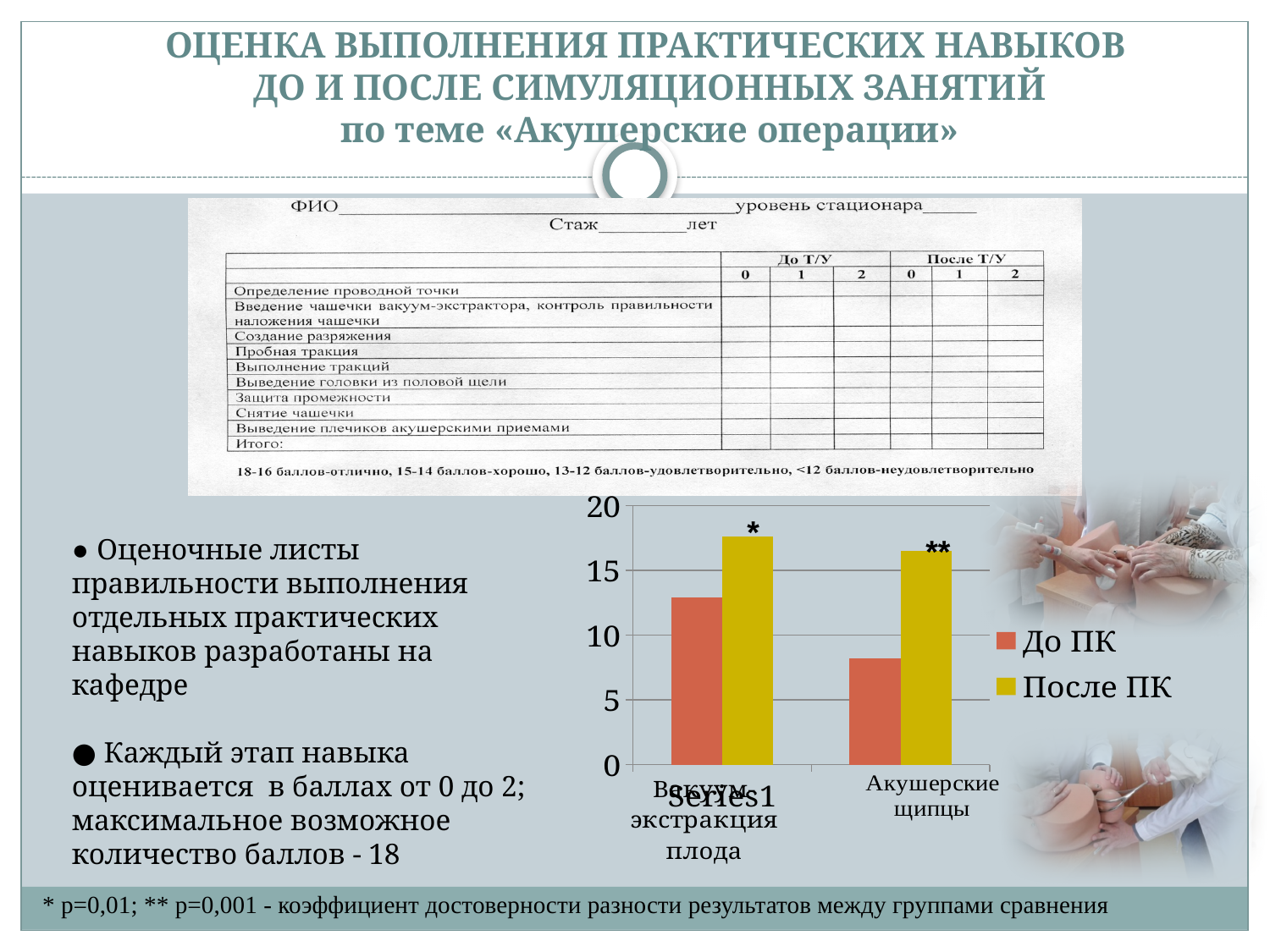
In the category 'Акушерские щипцы', which series has the larger value, 'До ПК' or 'После ПК'? После ПК Is the value for 'До ПК' in the category 'Вакуум-экстракция плода' greater or less than 10? greater Is the value for 'После ПК' in the category 'Вакуум-экстракция плода' greater or less than 15? greater Is the value for 'После ПК' in the category 'Акушерские щипцы' greater or less than 15? greater Which bar in the chart is the lowest? До ПК for Акушерские щипцы How many series does the chart legend list? 2 What kind of chart is shown on the slide? bar chart Which colour represents the series 'После ПК' in the chart? yellow What are the two series named in the chart legend? До ПК and После ПК How many categories are shown on the x axis of the chart? 2